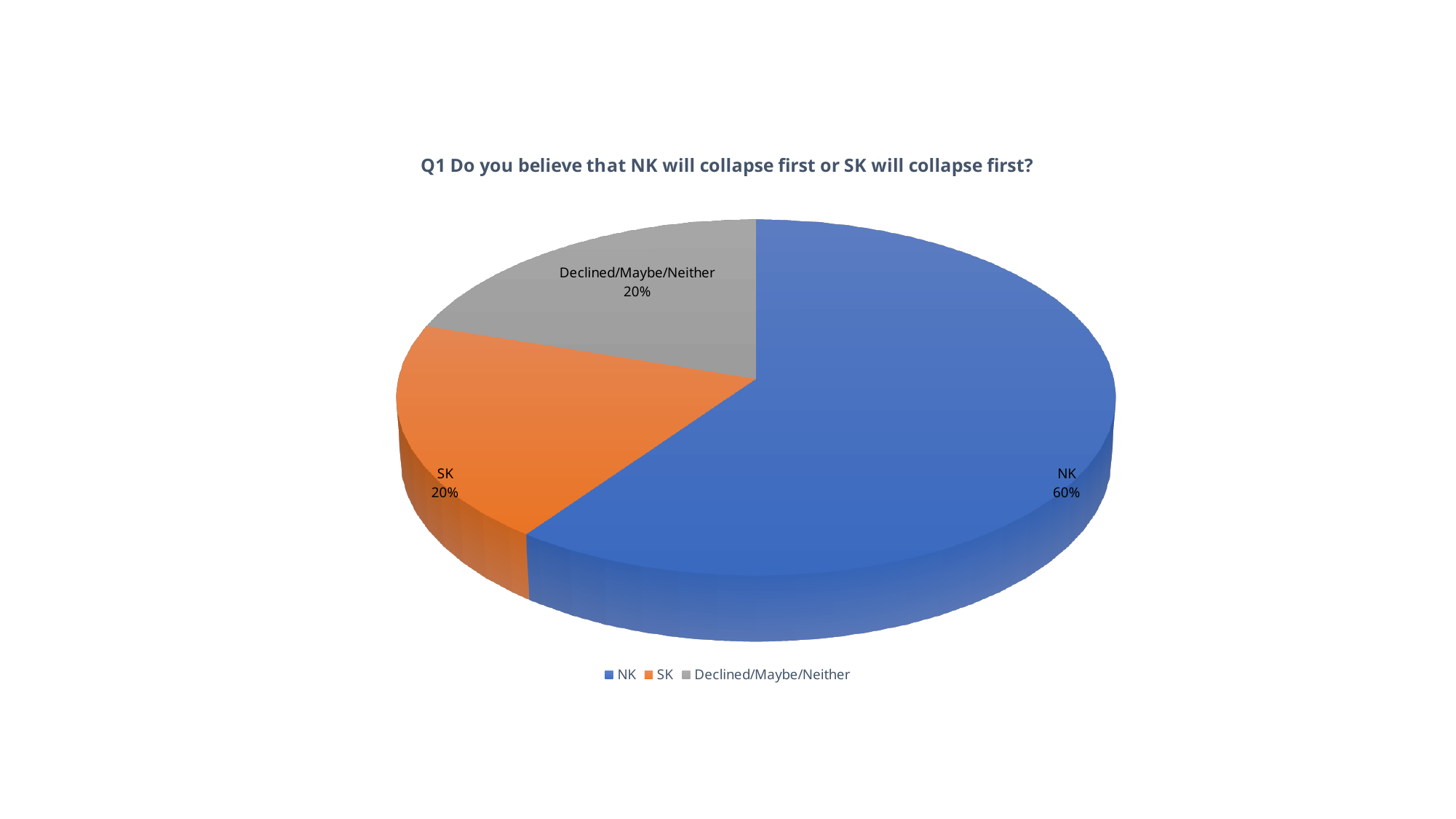
What is the combined share of SK and Declined/Maybe/Neither? 40% What share of the pie does Declined/Maybe/Neither have? 20% Which category has the largest slice of the pie? NK What share of the pie does NK have? 60% What is the difference in percentage points between NK and SK? 40 What share of the pie does SK have? 20% Which is larger, the NK slice or the Declined/Maybe/Neither slice? NK How many slices does the pie chart have? 3 What kind of chart is shown on the slide? Pie chart What is the title of the chart? Q1 Do you believe that NK will collapse first or SK will collapse first? What colour is the SK slice? Orange How many entries does the legend list? 3